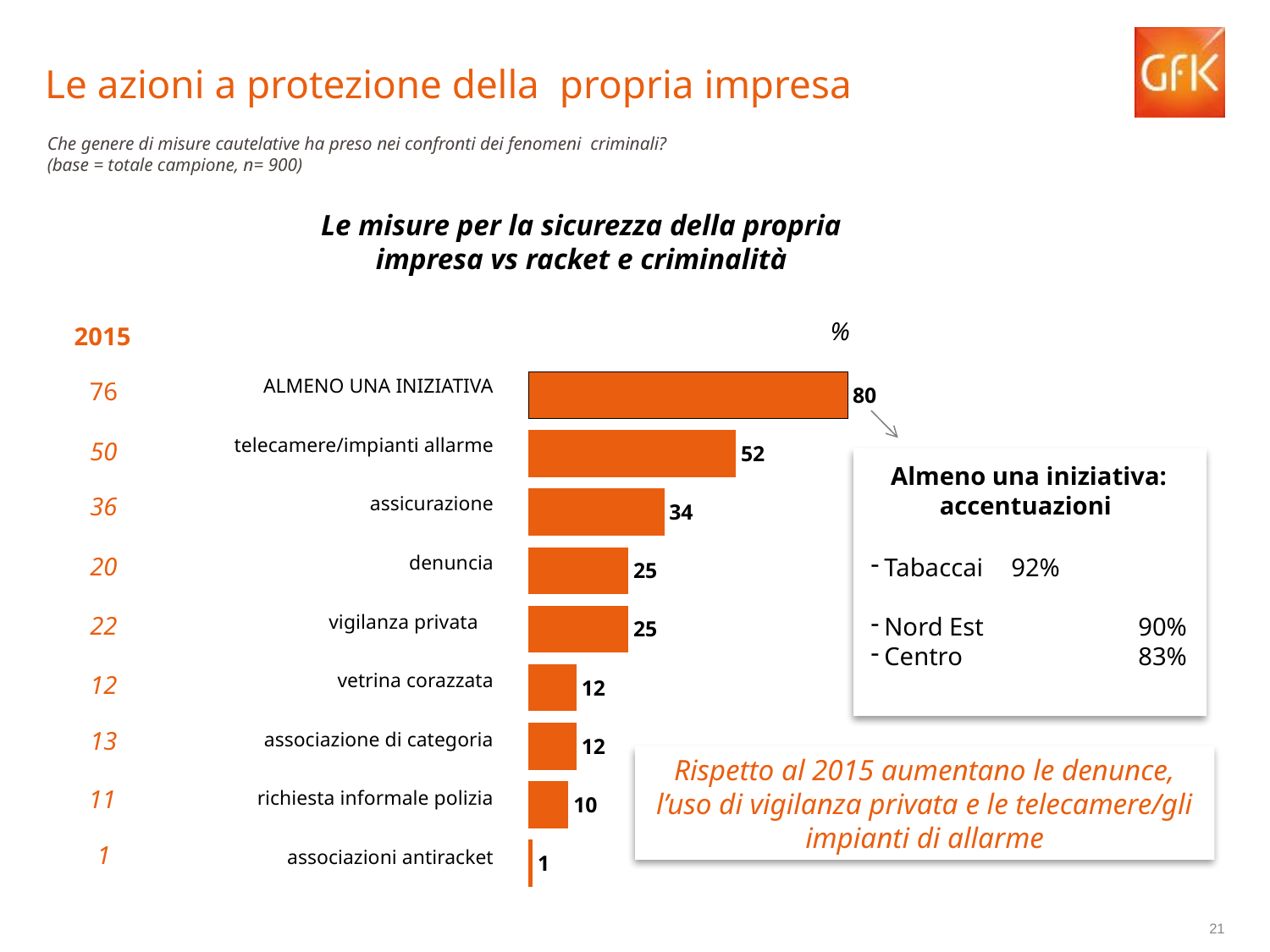
Which category has the highest value in the bar chart? ALMENO UNA INIZIATIVA What is the difference between the values for 'ALMENO UNA INIZIATIVA' and 'telecamere/impianti allarme'? 28 Which has a larger value, 'vetrina corazzata' or 'richiesta informale polizia'? vetrina corazzata What is the value for 'assicurazione' in the bar chart? 34 Which category has the lowest value in the bar chart? associazioni antiracket How many categories are shown in the bar chart? 9 What is the value for 'richiesta informale polizia' in the bar chart? 10 Which has a larger value, 'assicurazione' or 'denuncia'? assicurazione What type of chart is shown on the slide? bar chart What is the difference between the values for 'telecamere/impianti allarme' and 'assicurazione'? 18 What is the 2015 value listed for 'denuncia' on the slide? 20 What is the value for 'telecamere/impianti allarme' in the bar chart? 52